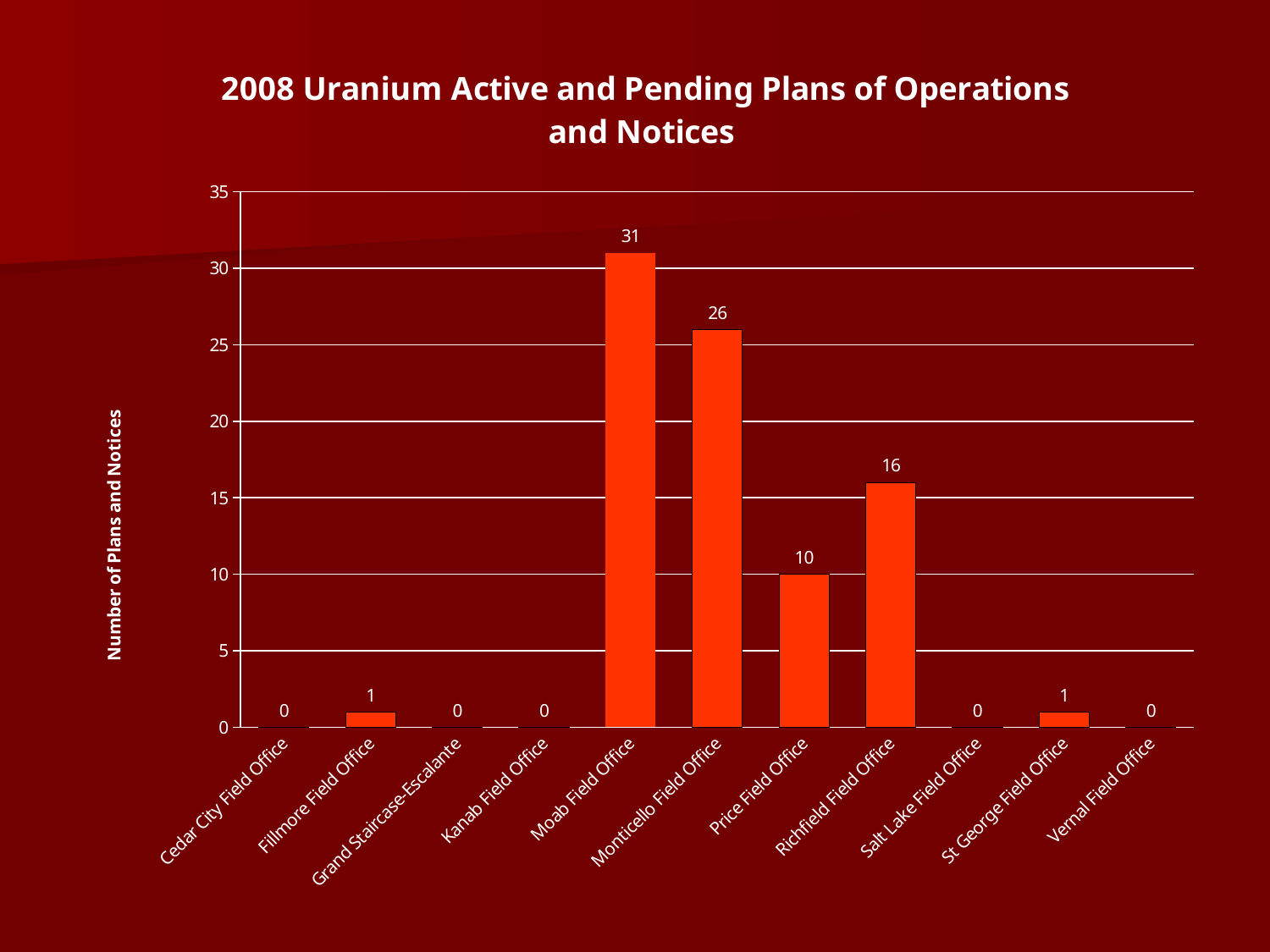
What is the value for Price Field Office? 10 What is the value for Moab Field Office? 31 What is the value for Monticello Field Office? 26 What is the label of the y axis? Number of Plans and Notices How many field offices are shown on the x axis? 11 What is the title of the chart? 2008 Uranium Active and Pending Plans of Operations and Notices What kind of chart is shown on the slide? Bar chart Which field office has the highest number of plans and notices? Moab Field Office What is the difference between the values for Moab Field Office and Monticello Field Office? 5 What is the value for Richfield Field Office? 16 How many field offices have a value of 0? 5 Which is larger, the value for Richfield Field Office or Price Field Office? Richfield Field Office